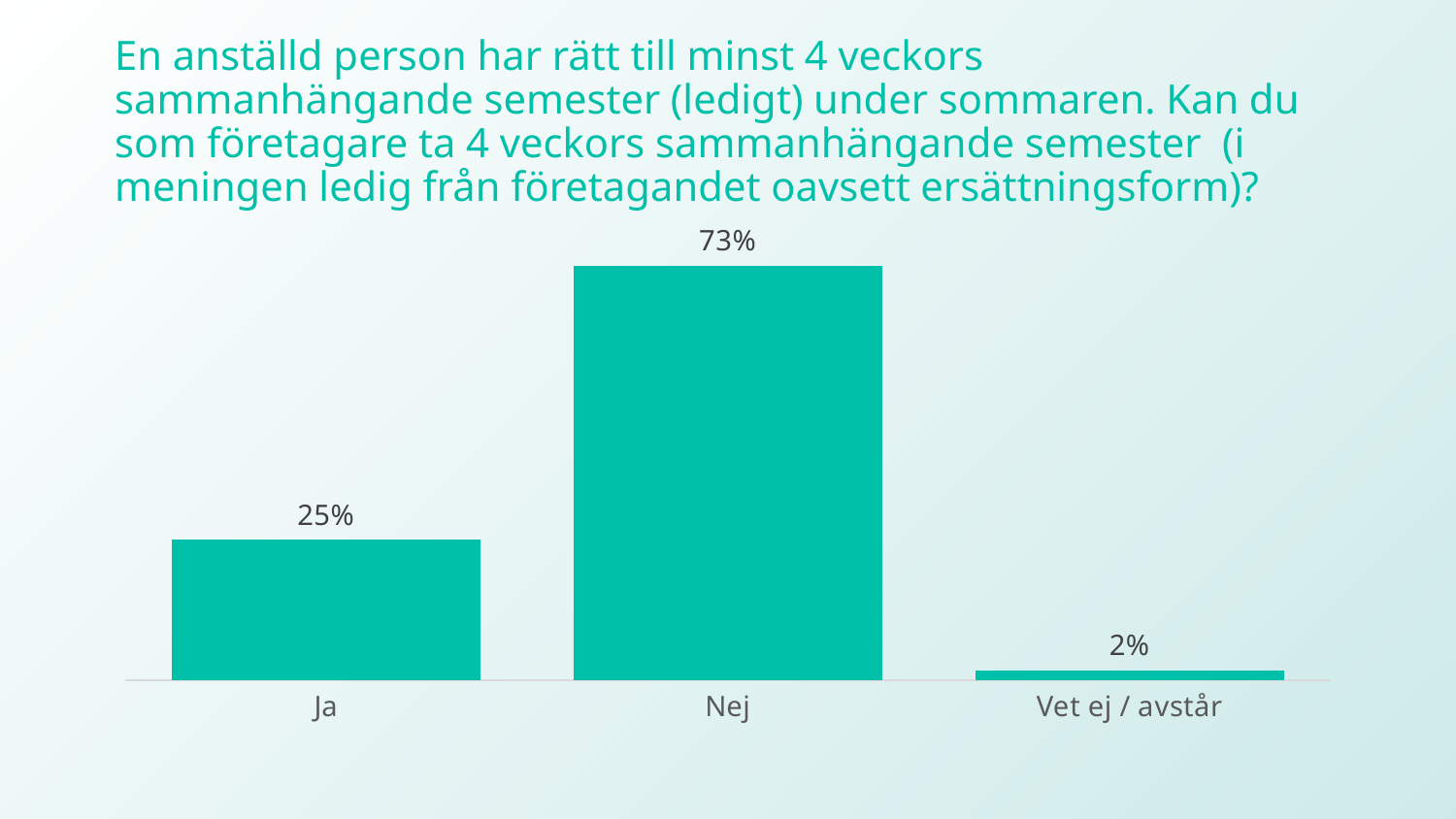
What is the difference between the values for Ja and Vet ej / avstår? 23% Which is larger, the value for Ja or the value for Nej? Nej What kind of chart is shown on the slide? Bar chart What is the label of the rightmost category on the x axis? Vet ej / avstår What is the value for Ja? 25% What is the value for Nej? 73% Which category has the lowest value? Vet ej / avstår How many categories are shown on the x axis? 3 What is the value for Vet ej / avstår? 2% What is the difference between the values for Nej and Ja? 48% What is the total of the values for Ja, Nej and Vet ej / avstår? 100% Which category has the highest value? Nej